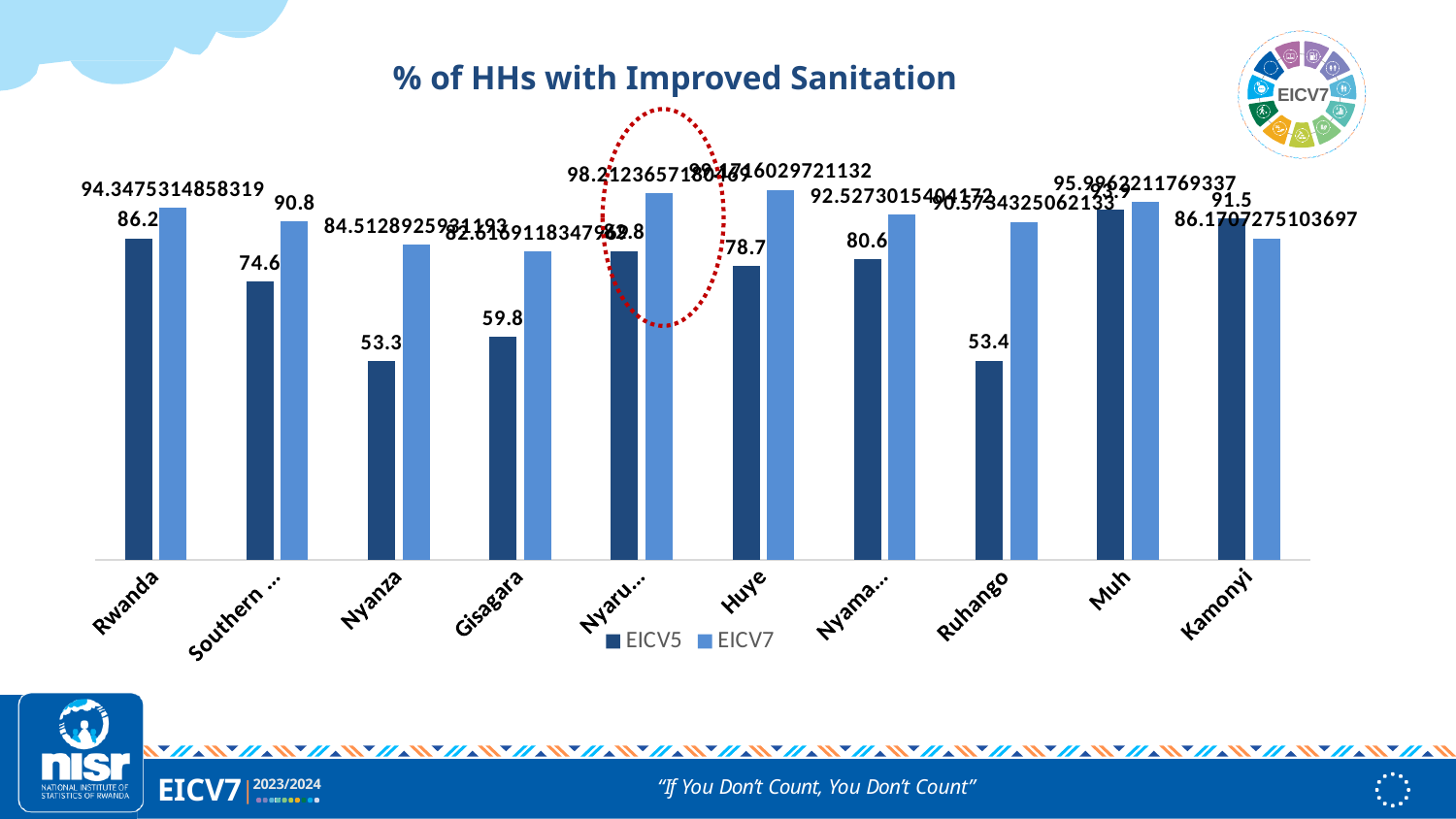
What is the EICV5 value for Kamonyi? 91.5 How many categories are shown on the x axis? 10 What is the EICV5 value for Rwanda? 86.2 What is the EICV7 value for Southern ...? 90.8 What is the EICV5 value for Southern ...? 74.6 For Kamonyi, which series has the larger value, EICV5 or EICV7? EICV5 What is the EICV7 value for Rwanda? 94.3475314858319 How many series does the legend list? 2 For Ruhango, which series has the larger value, EICV5 or EICV7? EICV7 What is the difference between the EICV5 values for Gisagara and Nyanza? 6.5 What is the difference between the EICV7 and EICV5 values for Southern ...? 16.2 What is the EICV5 value for Ruhango? 53.4